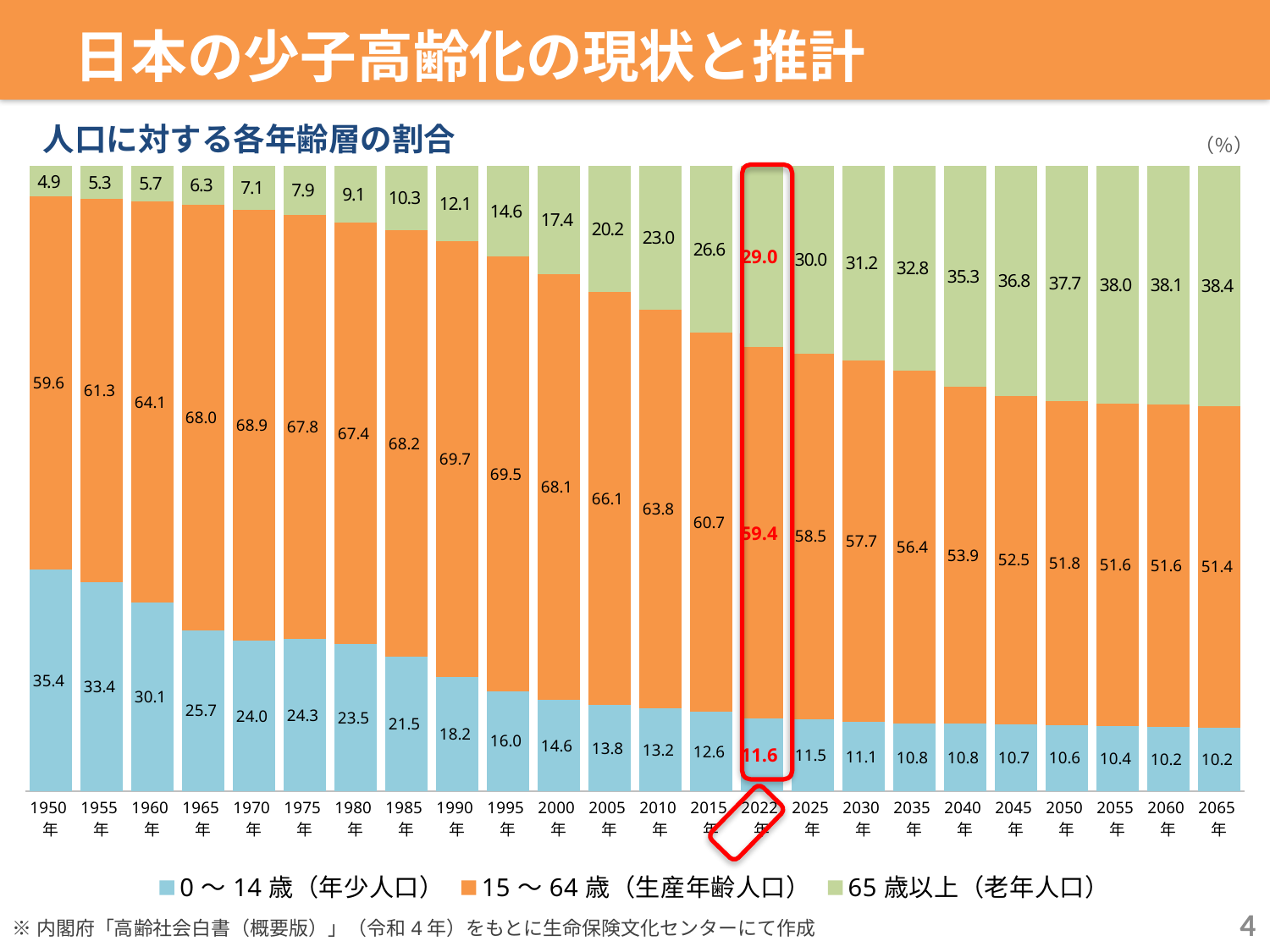
What is the difference between the 65歳以上 share in 2065年 and in 1950年? 33.5 How many series does the legend list? 3 What kind of chart is shown on the slide? Stacked bar chart In which year is the share of the 65歳以上 group highest? 2065年 What is the share of the 15～64歳 (生産年齢人口) group in 1990年? 69.7 In which year is the share of the 0～14歳 group highest? 1950年 What is the share of the 0～14歳 (年少人口) group in 1965年? 25.7 Which is larger, the 15～64歳 share in 2000年 or in 2040年? 2000年 Which year's bar is highlighted with a red outline? 2022年 How many years are shown along the x axis? 24 What is the share of the 65歳以上 (老年人口) group in 2022年? 29.0 Does the share of the 65歳以上 group rise or fall from 1950年 to 2065年? Rises